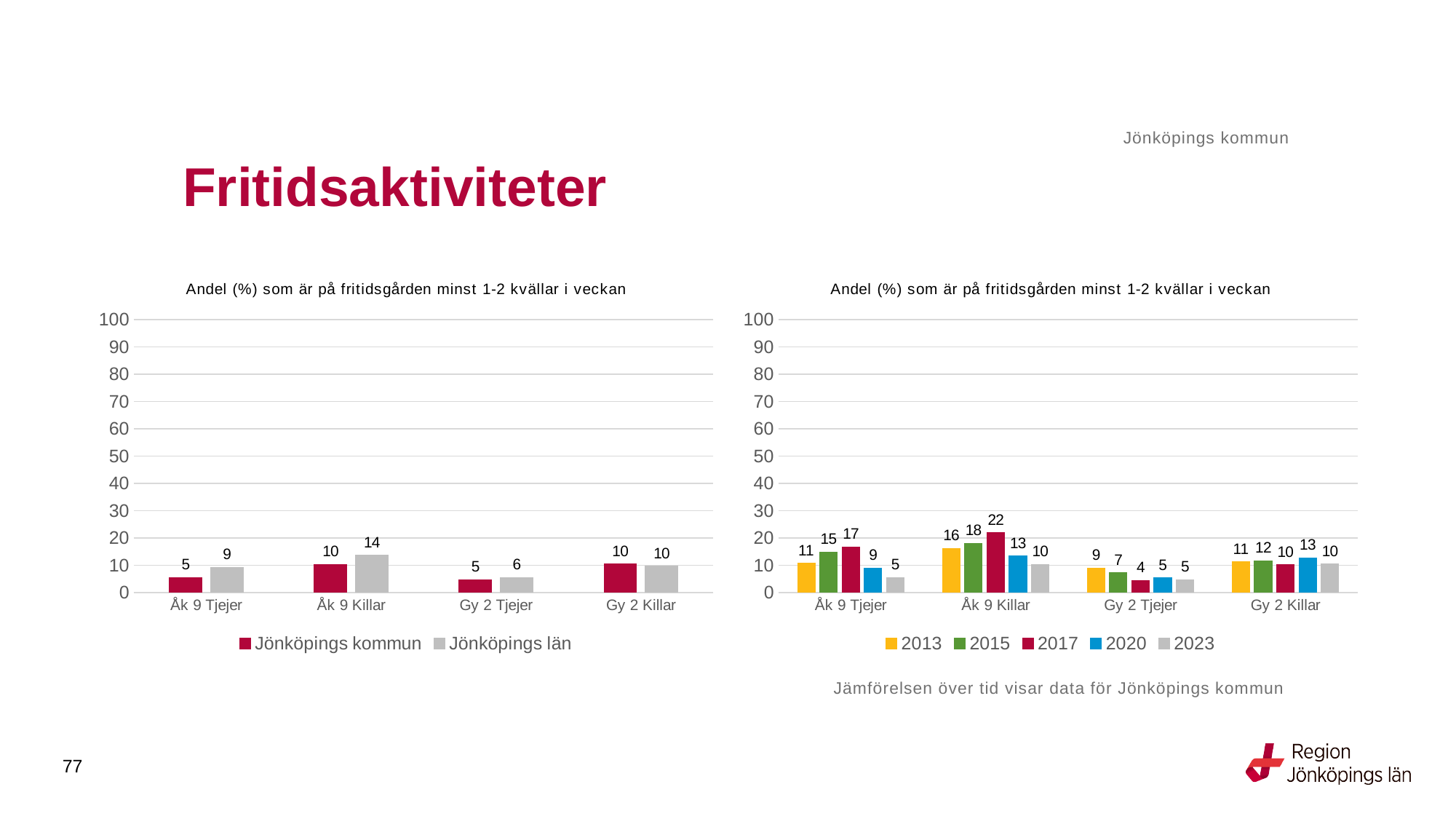
In the left chart, what is the value for Jönköpings län for Åk 9 Killar? 14 In the right chart, is the value for 2013 for Åk 9 Killar larger or smaller than the value for 2020 for Åk 9 Killar? larger In the left chart, how many series does the legend list? 2 What kind of chart is the right chart? bar chart In the left chart, what is the difference between Jönköpings län and Jönköpings kommun for Åk 9 Tjejer? 4 In the left chart, which category has the highest value for Jönköpings län? Åk 9 Killar In the right chart, how many series does the legend list? 5 In the right chart, what is the value for 2017 for Åk 9 Killar? 22 In the right chart, how many categories are shown on the x axis? 4 In the left chart, what is the value for Jönköpings kommun for Gy 2 Tjejer? 5 In the right chart, which year has the lowest value for Gy 2 Tjejer? 2017 In the right chart, what is the value for 2023 for Åk 9 Tjejer? 5